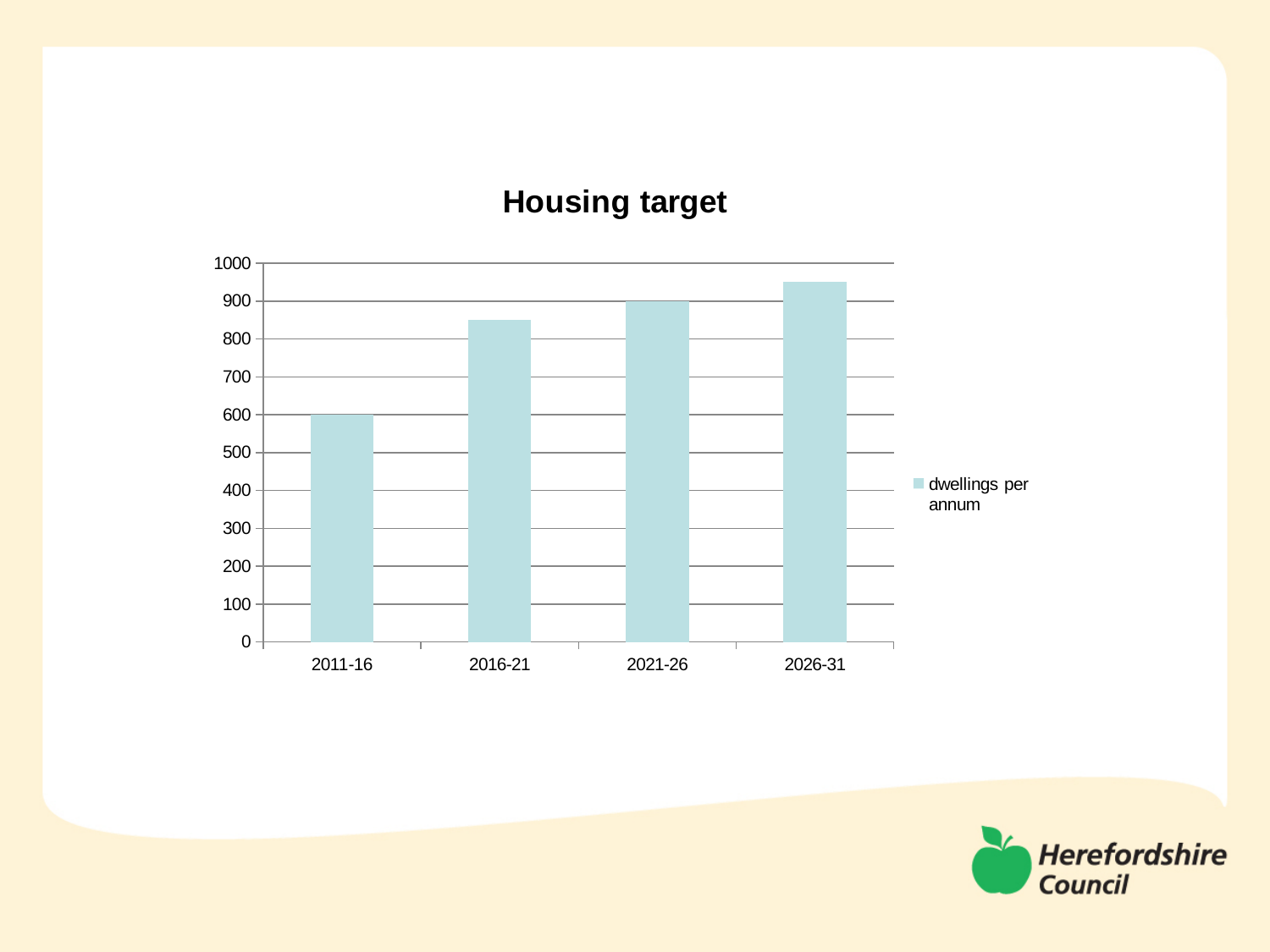
What is the difference between the values for 2021-26 and 2011-16? 300 Is the value for 2026-31 greater or less than 900? greater Which period has the lowest value? 2011-16 What is the value for 2011-16? 600 Which period has the highest value? 2026-31 Is the value for 2016-21 greater or less than 800? greater Which is larger, the value for 2016-21 or the value for 2011-16? 2016-21 How many series does the legend list? 1 How many periods are shown on the x axis? 4 What is the value for 2021-26? 900 Do the values rise or fall from 2011-16 to 2026-31? rise What kind of chart is this? bar chart